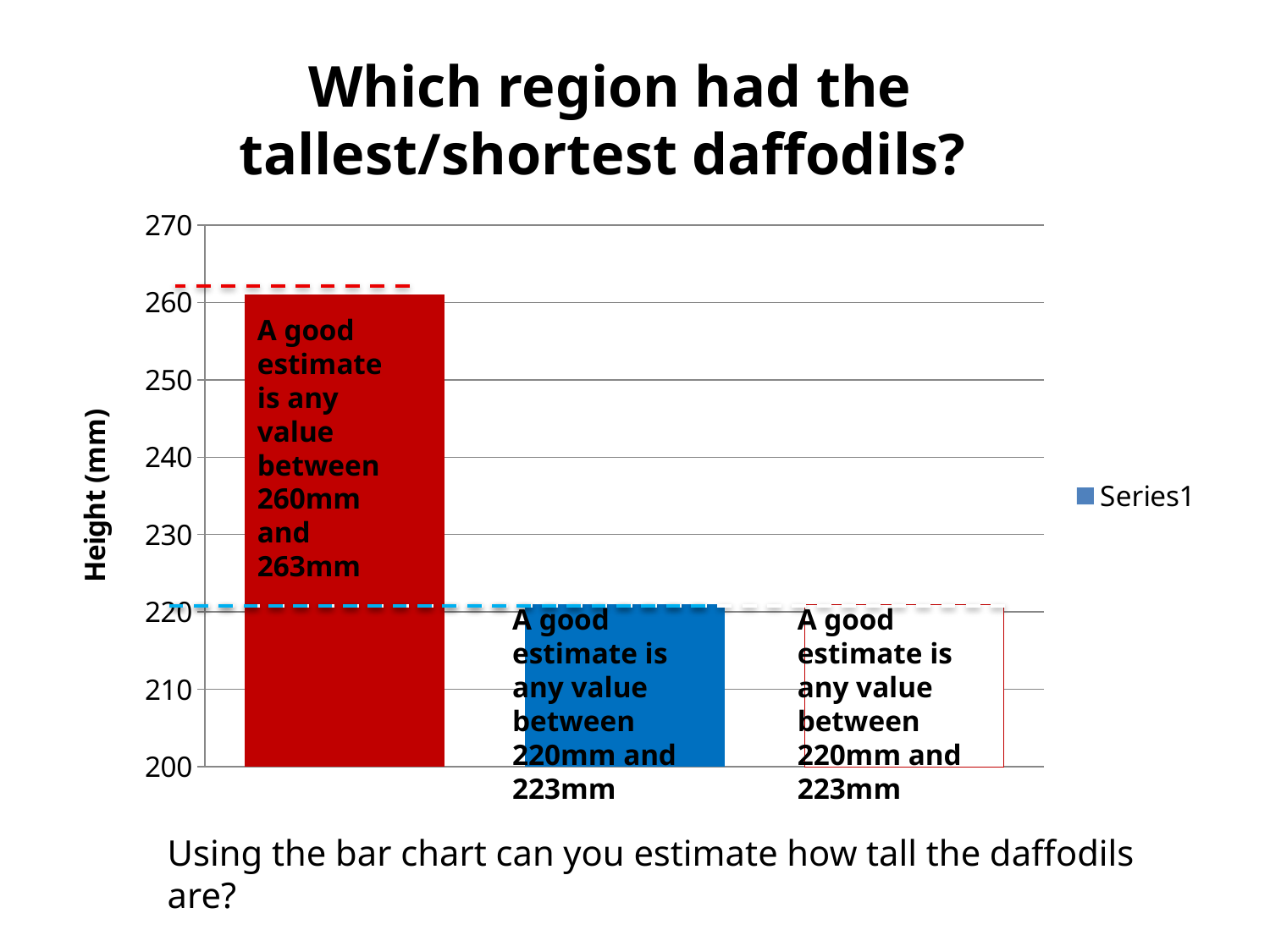
What is the title of the vertical axis? Height (mm) Is the value of the middle bar greater or less than 230? less Is the value of the rightmost bar greater or less than 240? less Is the value of the leftmost bar greater or less than 270? less Which bar is the tallest: the leftmost, middle or rightmost? leftmost What kind of chart is shown on the slide? bar chart How many series does the legend list? 1 What entry does the legend show? Series1 Which is larger, the leftmost bar or the middle bar? leftmost bar How many bars are plotted in the chart? 3